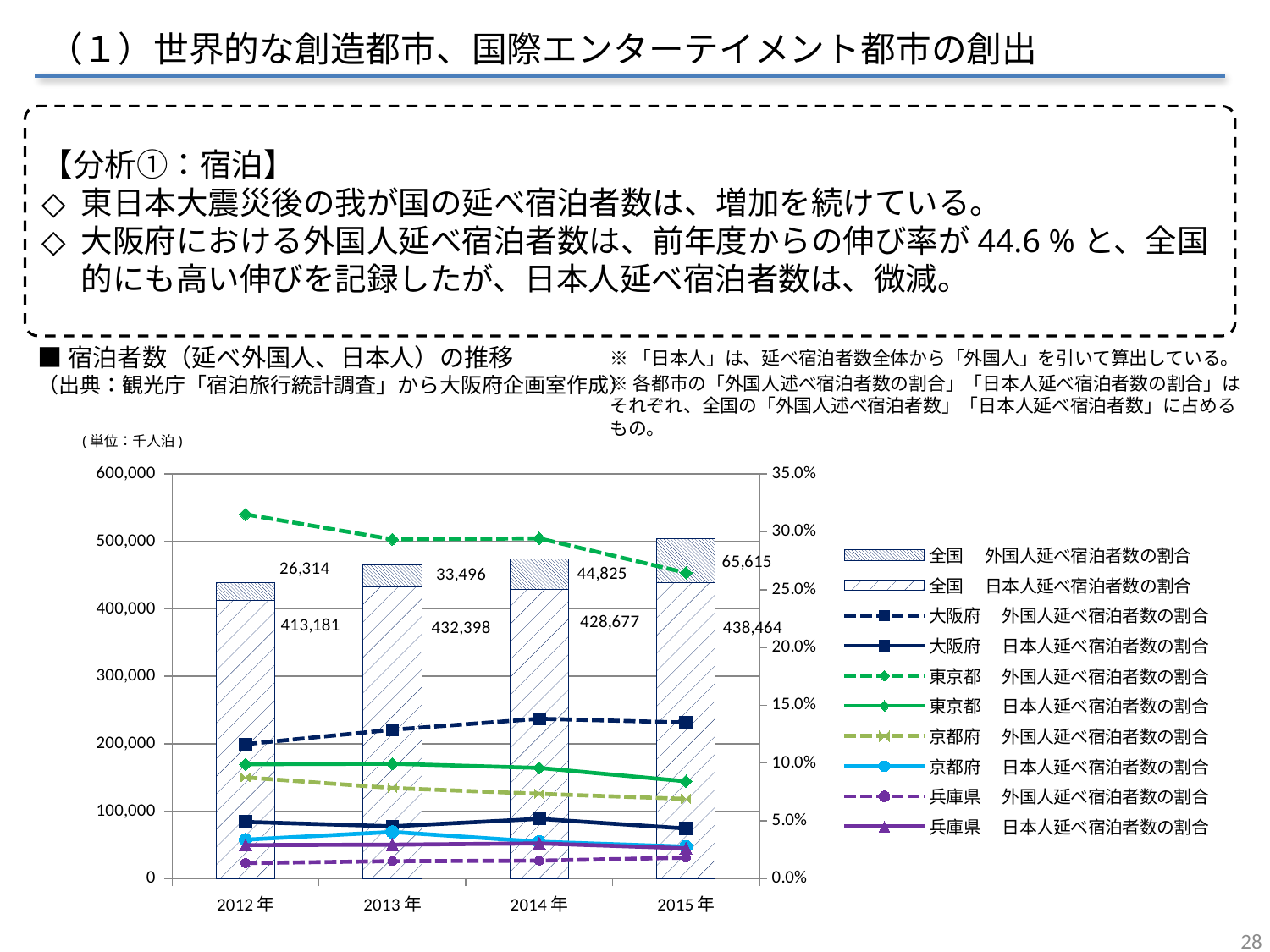
In which year is the 全国 外国人延べ宿泊者数 bar segment the highest? 2015年 What is the value of 全国 外国人延べ宿泊者数 in 2015? 65,615 What kind of chart is shown on the slide? A combined bar and line chart What is the difference between the 全国 外国人延べ宿泊者数 values for 2015 and 2012? 39,301 In which year is the 全国 日本人延べ宿泊者数 bar segment the lowest? 2012年 Does the 全国 外国人延べ宿泊者数 segment rise or fall from 2012 to 2015? Rises Is the 東京都 外国人延べ宿泊者数の割合 value for 2012 greater or less than 30.0%? greater How many years are shown on the x axis? 4 What is the value of 全国 日本人延べ宿泊者数 in 2013? 432,398 What is the total of the stacked bar for 2015? 504,079 How many series does the legend list? 10 Which is larger, the 全国 日本人延べ宿泊者数 value for 2013 or for 2014? 2013 (432,398)